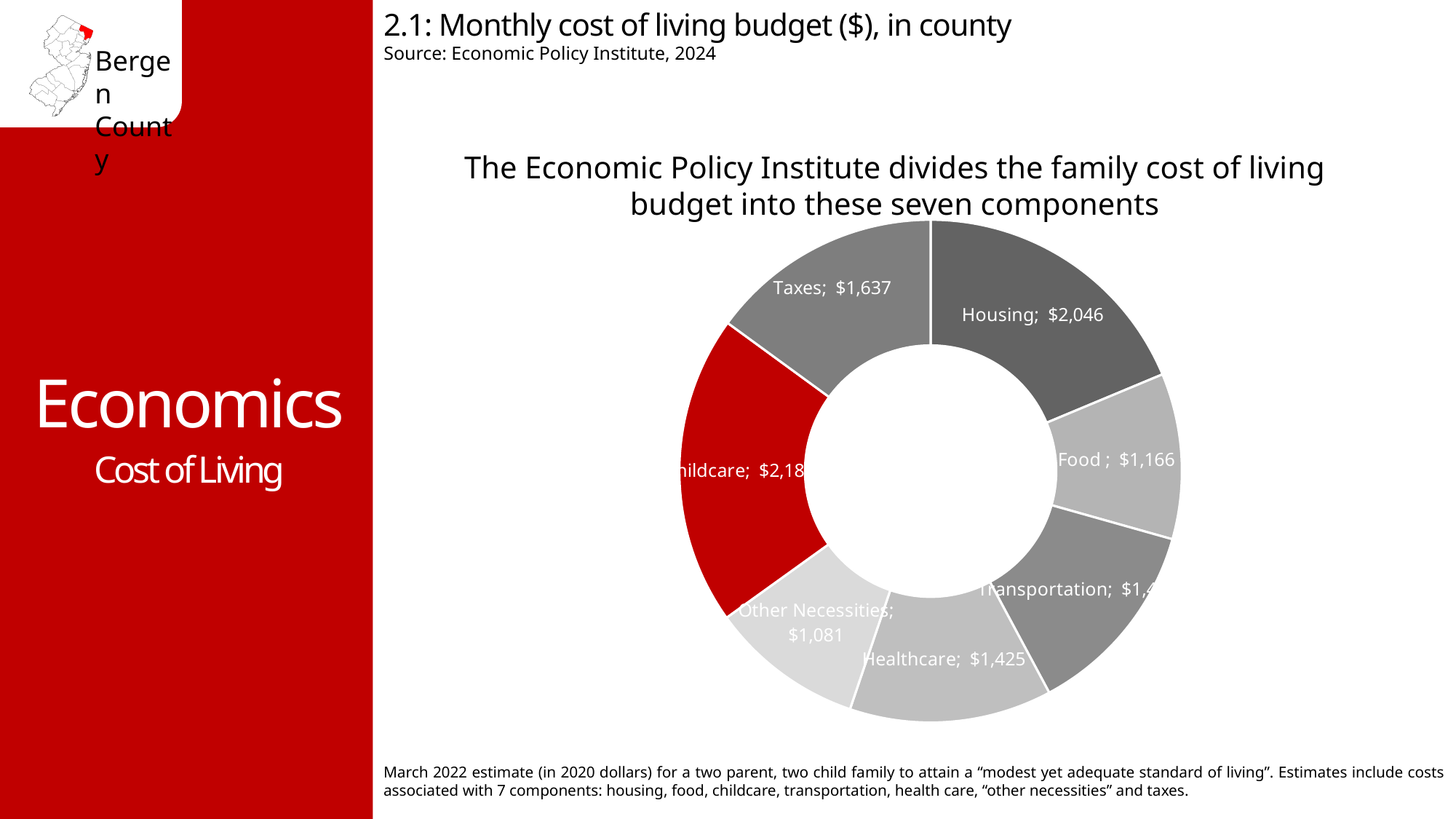
Which component has the smallest monthly cost in the chart? Other Necessities What is the monthly cost for Taxes in the chart? $1,637 How many components are shown in the chart? 7 What is the monthly cost for Healthcare in the chart? $1,425 What is the monthly cost for Housing in the chart? $2,046 What is the difference between the Healthcare cost and the Other Necessities cost? $344 Which is larger, the cost for Housing or the cost for Taxes? Housing How much larger is the Housing cost than the Taxes cost? $409 What is the monthly cost for Food in the chart? $1,166 What is the monthly cost for Other Necessities in the chart? $1,081 Which component has the largest monthly cost in the chart? Childcare What type of chart is used on the slide? Pie (doughnut) chart